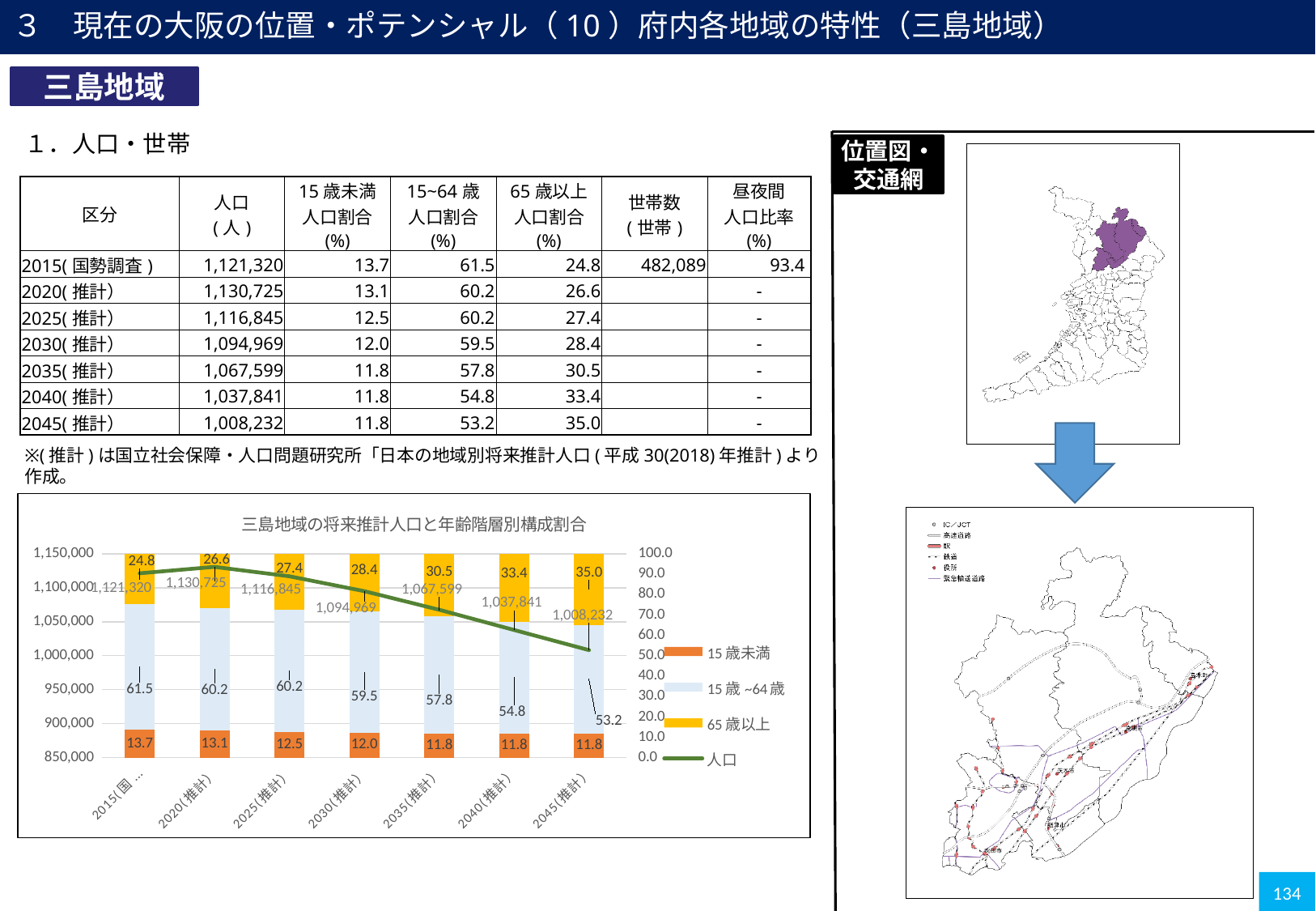
What kind of chart is 三島地域の将来推計人口と年齢階層別構成割合? Stacked bar chart with a line In the chart 三島地域の将来推計人口と年齢階層別構成割合, what is the difference between the 65歳以上 value for 2045(推計) and for 2015? 10.2 In the chart 三島地域の将来推計人口と年齢階層別構成割合, do the 65歳以上 values rise or fall from 2015 to 2045(推計)? rise In the chart 三島地域の将来推計人口と年齢階層別構成割合, which year has the highest 人口 value? 2020(推計) In the chart 三島地域の将来推計人口と年齢階層別構成割合, which year has the lowest 人口 value? 2045(推計) In the chart 三島地域の将来推計人口と年齢階層別構成割合, what is the 人口 value for 2020(推計)? 1,130,725 In the chart 三島地域の将来推計人口と年齢階層別構成割合, is the 15歳~64歳 value larger for 2015 or for 2045(推計)? 2015 How many years (categories) are shown on the x axis of the chart 三島地域の将来推計人口と年齢階層別構成割合? 7 In the chart 三島地域の将来推計人口と年齢階層別構成割合, what is the total of the stacked bar for 2015 (15歳未満 + 15歳~64歳 + 65歳以上)? 100.0 In the chart 三島地域の将来推計人口と年齢階層別構成割合, what is the value of 65歳以上 for 2045(推計)? 35.0 In the chart 三島地域の将来推計人口と年齢階層別構成割合, what is the value of 15歳~64歳 for 2040(推計)? 54.8 How many series does the legend of the chart 三島地域の将来推計人口と年齢階層別構成割合 list? 4